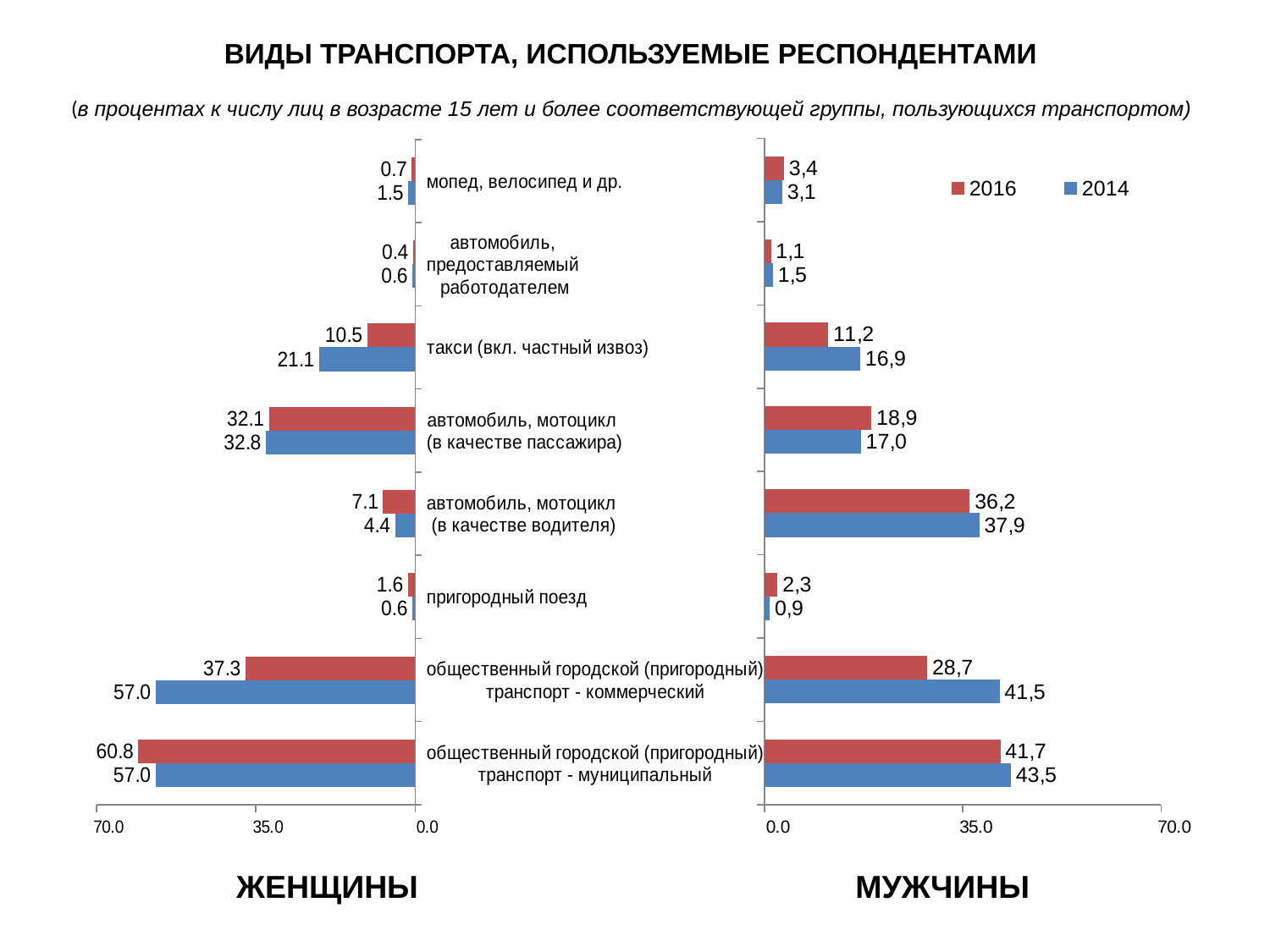
On the ЖЕНЩИНЫ chart, is the 2014 value for общественный городской (пригородный) транспорт - коммерческий greater or less than 35.0? greater How many series does the legend list? 2 On the МУЖЧИНЫ chart, which category has the lowest 2014 value? пригородный поезд On the МУЖЧИНЫ chart, what is the 2014 value for автомобиль, мотоцикл (в качестве водителя)? 37,9 On the ЖЕНЩИНЫ chart, which category has the highest 2016 value? общественный городской (пригородный) транспорт - муниципальный What type of chart is the МУЖЧИНЫ chart? bar chart On the МУЖЧИНЫ chart, which is larger for автомобиль, мотоцикл (в качестве пассажира): the 2016 value or the 2014 value? 2016 On the МУЖЧИНЫ chart, what is the difference between the 2014 and 2016 values for такси (вкл. частный извоз)? 5,7 How many transport categories are shown on the ЖЕНЩИНЫ chart? 8 On the ЖЕНЩИНЫ chart, what is the difference between the 2014 and 2016 values for общественный городской (пригородный) транспорт - коммерческий? 19.7 On the ЖЕНЩИНЫ chart, what is the 2016 value for такси (вкл. частный извоз)? 10.5 Which colour represents the 2014 series in the legend? blue